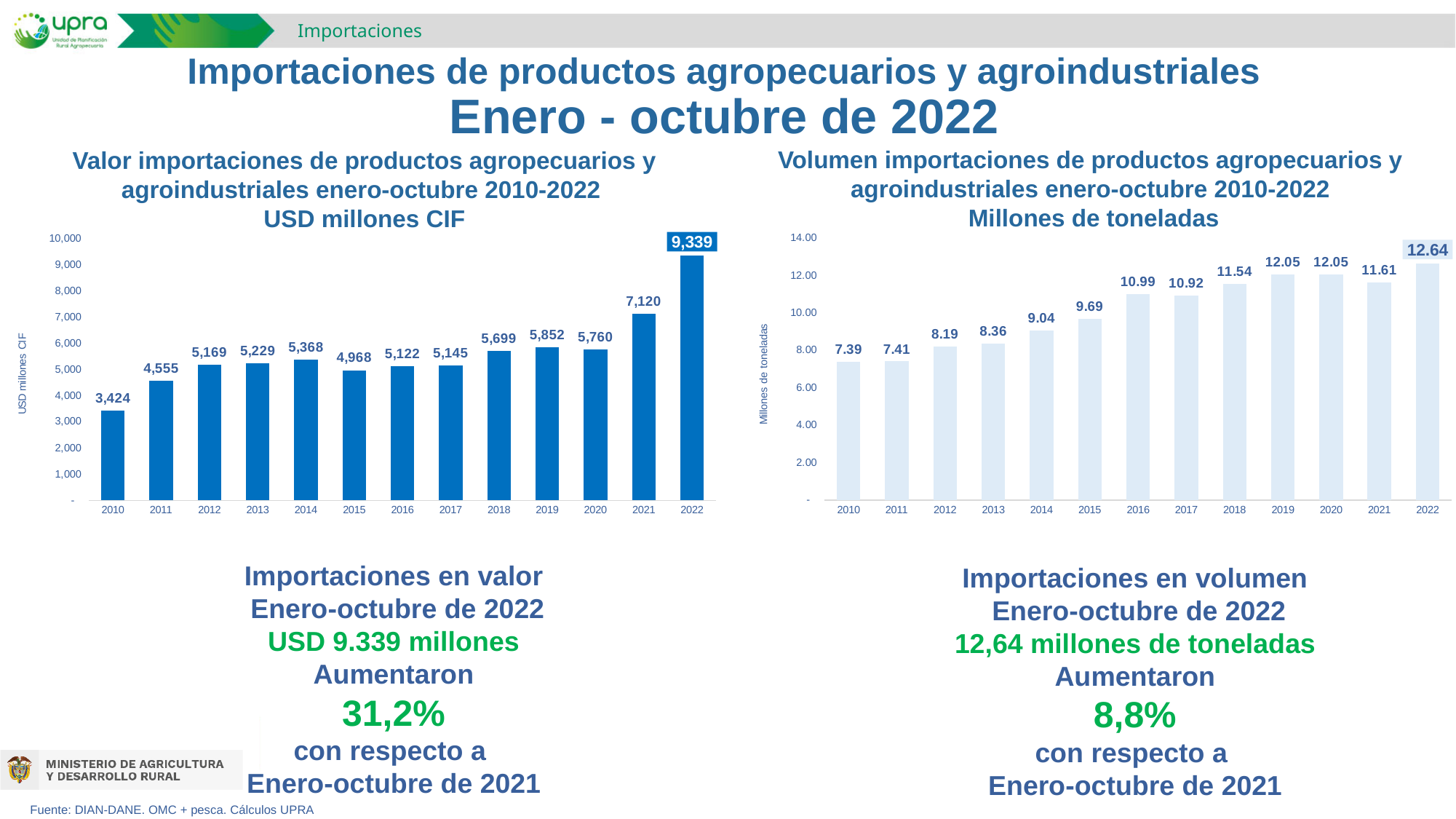
In the right chart (Volumen importaciones, Millones de toneladas), is the value for 2014 greater or less than 10.00? less In the right chart (Volumen importaciones, Millones de toneladas), what is the value for 2016? 10.99 In the left chart (Valor importaciones, USD millones CIF), how many years are plotted? 13 In the left chart (Valor importaciones, USD millones CIF), which year has the lowest value? 2010 In the left chart (Valor importaciones, USD millones CIF), what is the difference between the 2022 and 2021 values? 2,219 In the left chart (Valor importaciones, USD millones CIF), what is the value for 2015? 4,968 In the right chart (Volumen importaciones, Millones de toneladas), what is the y-axis label? Millones de toneladas What kind of chart is the right chart (Volumen importaciones, Millones de toneladas)? bar chart In the right chart (Volumen importaciones, Millones de toneladas), what is the difference between the 2022 and 2021 values? 1.03 In the right chart (Volumen importaciones, Millones de toneladas), which year has the highest value? 2022 In the left chart (Valor importaciones, USD millones CIF), which is larger, the value for 2019 or the value for 2020? 2019 In the left chart (Valor importaciones, USD millones CIF), what is the value for 2022? 9,339